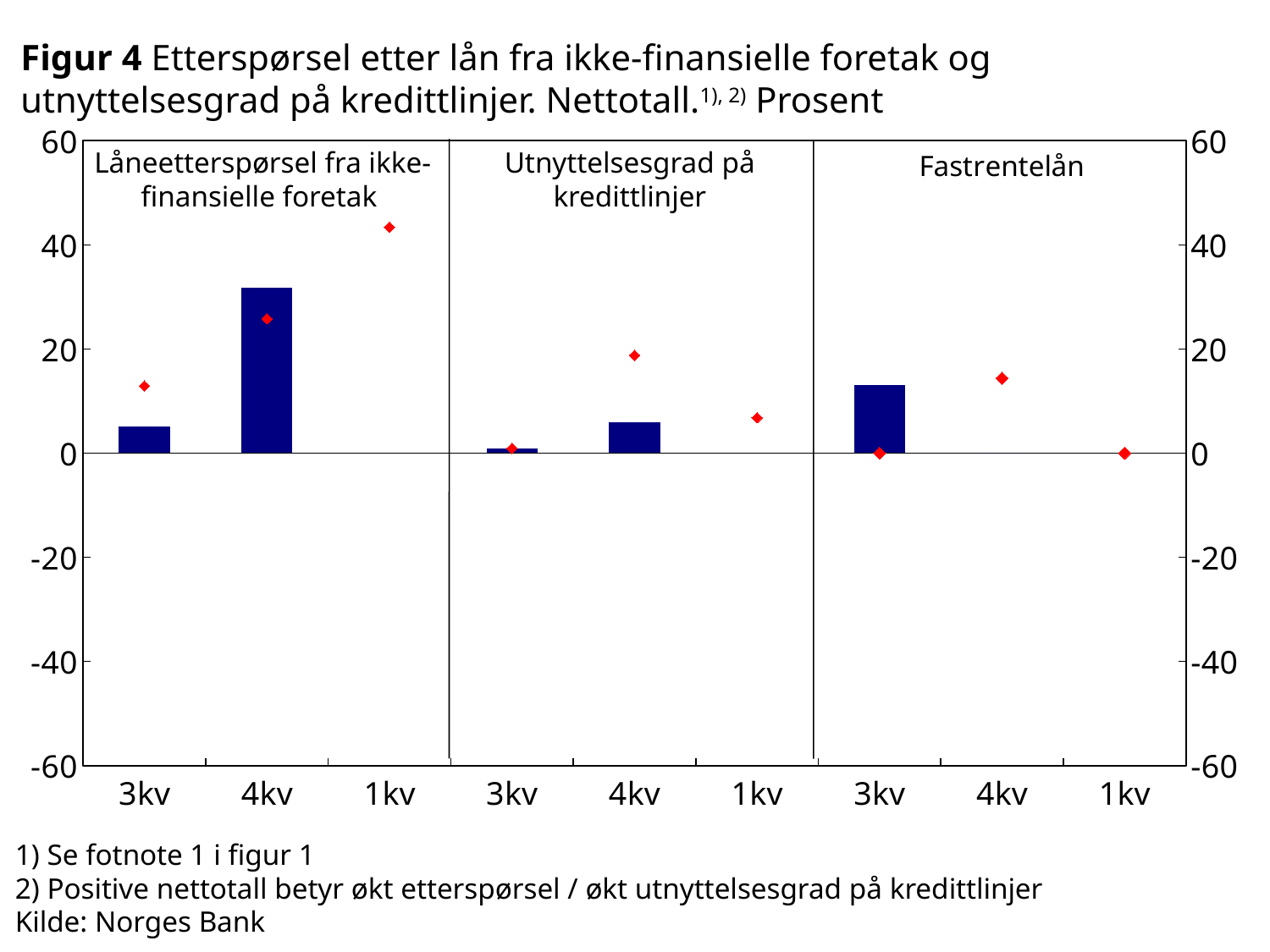
In the panel 'Låneetterspørsel fra ikke-finansielle foretak', do the values rise or fall from 3kv to 1kv? rise In the panel 'Låneetterspørsel fra ikke-finansielle foretak', is the bar for 4kv greater or less than 20? greater What kind of chart is shown on the slide? bar chart In the panel 'Utnyttelsesgrad på kredittlinjer', is the bar for 4kv greater or less than 20? less Which is larger: the 4kv bar in the panel 'Låneetterspørsel fra ikke-finansielle foretak' or the 4kv bar in the panel 'Utnyttelsesgrad på kredittlinjer'? Låneetterspørsel fra ikke-finansielle foretak How many quarters are shown on the x axis of each panel? 3 In the panel 'Låneetterspørsel fra ikke-finansielle foretak', is the bar for 4kv greater or less than 40? less What source is given for the chart? Norges Bank In the panel 'Låneetterspørsel fra ikke-finansielle foretak', which quarter has the highest bar? 4kv What is the title of the third panel of the chart? Fastrentelån How many panels does the chart have? 3